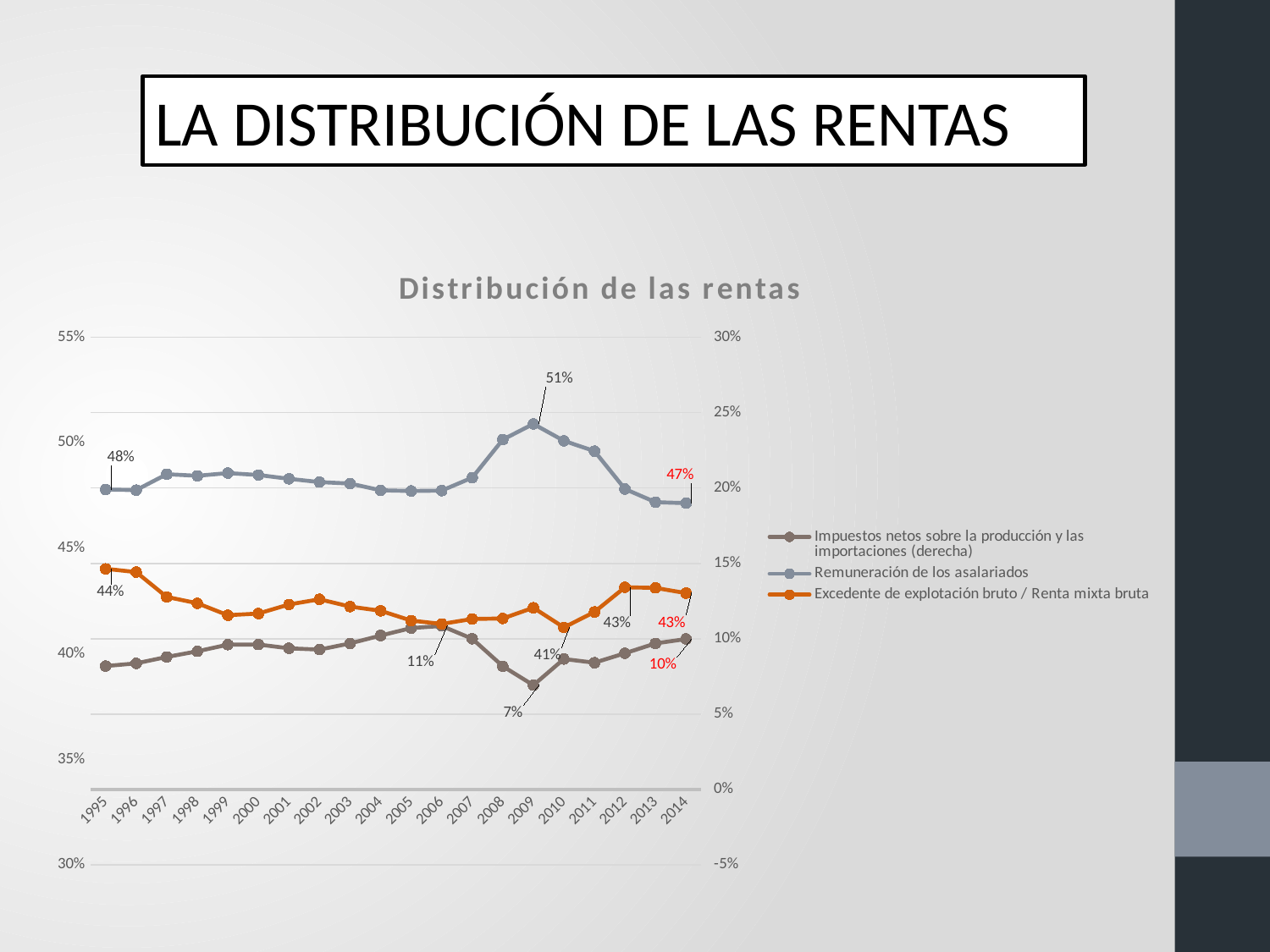
What is the difference between the Remuneración de los asalariados values in 2009 and 2014? 4% What type of chart is shown on the slide? line chart What is the value of Remuneración de los asalariados in 2009? 51% What is the value of Excedente de explotación bruto / Renta mixta bruta in 1995? 44% How many series does the legend list? 3 What is the title of the chart? Distribución de las rentas What is the value of Remuneración de los asalariados in 1995? 48% What is the value of Remuneración de los asalariados in 2014? 47% What is the value of Impuestos netos sobre la producción y las importaciones in 2009? 7% In which year does Remuneración de los asalariados reach its highest value? 2009 What is the value of Impuestos netos sobre la producción y las importaciones in 2014? 10% How many years are shown on the x axis? 20